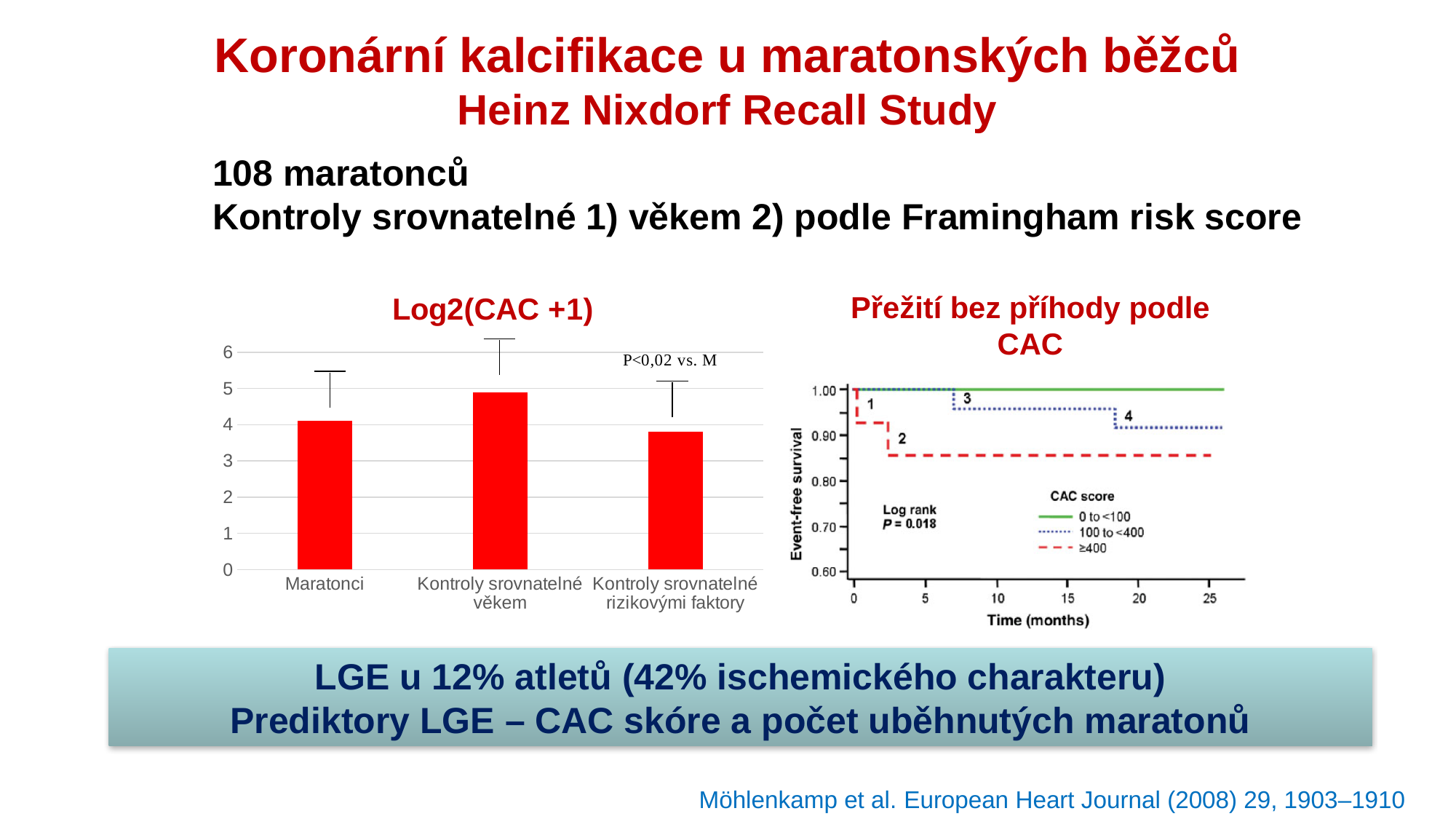
In the Log2(CAC +1) bar chart, is the value for Kontroly srovnatelné rizikovými faktory greater or less than 4? less In the Log2(CAC +1) bar chart, which category has the highest bar? Kontroly srovnatelné věkem What kind of chart is the Log2(CAC +1) chart on the left? bar chart How many categories are shown in the Log2(CAC +1) bar chart? 3 How many CAC score groups does the legend of the 'Přežití bez příhody podle CAC' chart list? 3 In the Log2(CAC +1) bar chart, which category has the lowest bar? Kontroly srovnatelné rizikovými faktory In the Log2(CAC +1) bar chart, which is larger: the value for Maratonci or for Kontroly srovnatelné věkem? Kontroly srovnatelné věkem In the 'Přežití bez příhody podle CAC' chart, which CAC score group has the lowest event-free survival at 25 months? ≥400 In the Log2(CAC +1) bar chart, is the value for Kontroly srovnatelné věkem greater or less than 4? greater In the Log2(CAC +1) bar chart, what P value is printed above the Kontroly srovnatelné rizikovými faktory bar? P<0,02 vs. M What log rank P value is printed on the 'Přežití bez příhody podle CAC' chart? P = 0.018